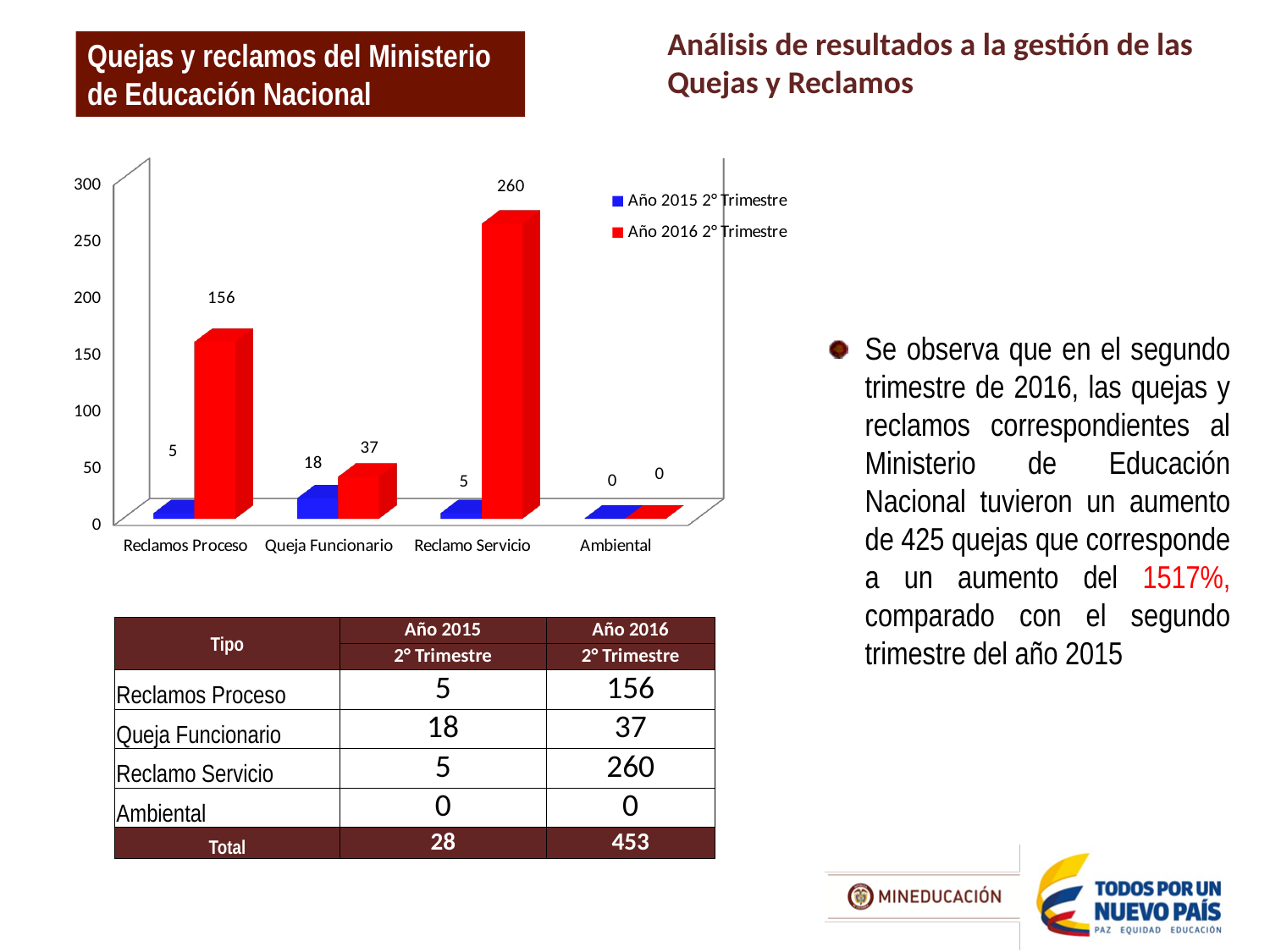
How many categories are shown on the x axis of the chart? 4 What is the difference between the Año 2016 2° Trimestre and Año 2015 2° Trimestre values for Reclamos Proceso? 151 Which category has the highest value in the Año 2015 2° Trimestre series? Queja Funcionario What is the value for Reclamos Proceso in the Año 2016 2° Trimestre series? 156 What kind of chart is shown on the slide? bar chart What is the value for Reclamo Servicio in the Año 2016 2° Trimestre series? 260 What is the value for Queja Funcionario in the Año 2015 2° Trimestre series? 18 What colour represents the Año 2016 2° Trimestre series in the chart? red How many series does the chart legend list? 2 Is the value for Reclamo Servicio in the Año 2016 2° Trimestre series greater or less than 250? greater Which is larger for Queja Funcionario: the Año 2015 2° Trimestre value or the Año 2016 2° Trimestre value? Año 2016 2° Trimestre Which category has the highest value in the Año 2016 2° Trimestre series? Reclamo Servicio